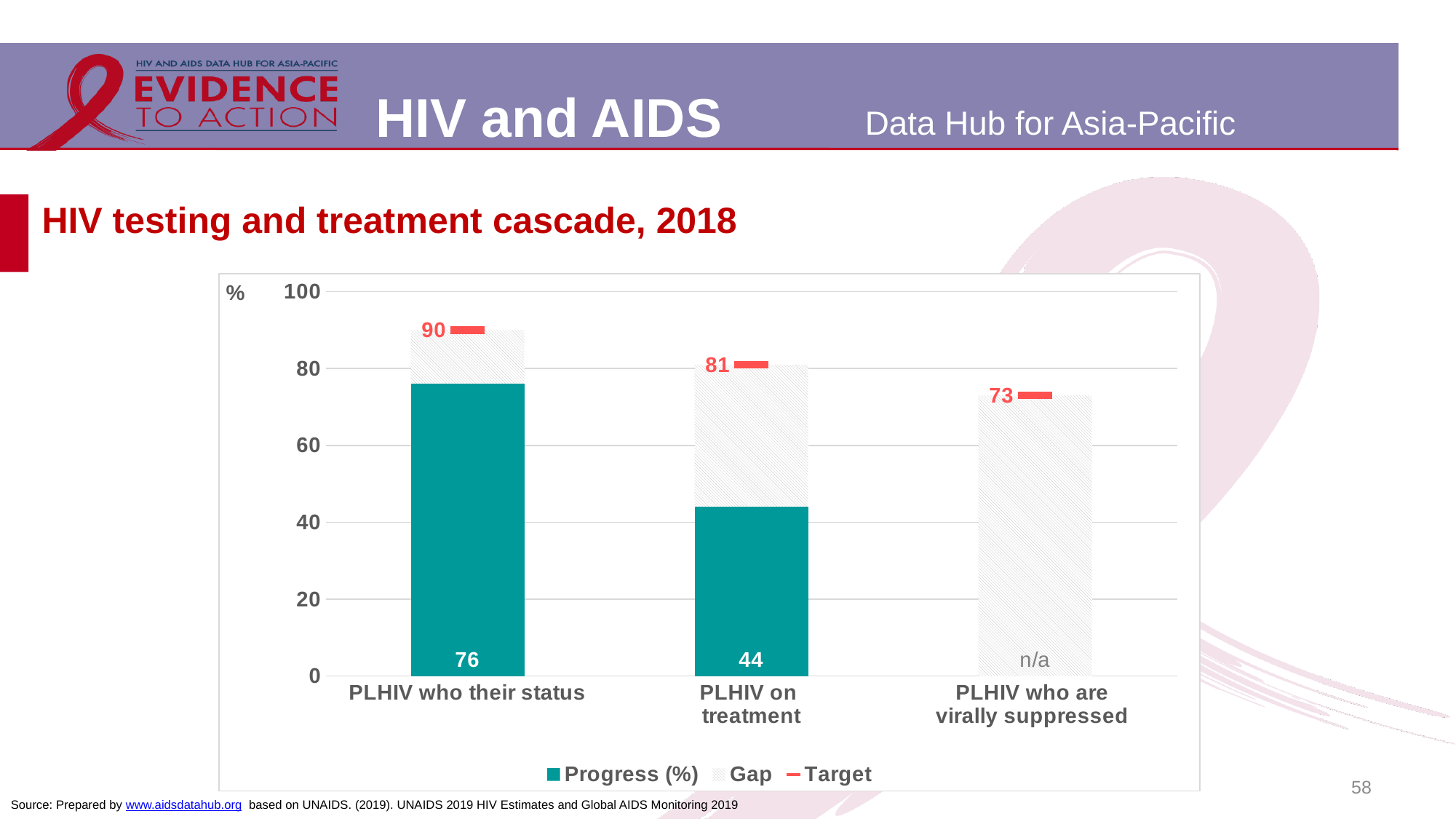
Which category has the lowest Target value? PLHIV who are virally suppressed What is the title of the chart? HIV testing and treatment cascade, 2018 What is the Target value for PLHIV who are virally suppressed? 73 What is the difference between the Target and the Progress (%) value for PLHIV on treatment? 37 Which is larger, the Progress (%) value for PLHIV who know their status or for PLHIV on treatment? PLHIV who their status What is the Progress (%) value for PLHIV on treatment? 44 How many series does the legend list? 3 Which category has the highest Target value? PLHIV who their status What is the Target value for PLHIV who know their status? 90 What is the Progress (%) value shown for PLHIV who are virally suppressed? n/a What is the Progress (%) value for PLHIV who know their status? 76 What is the Target value for PLHIV on treatment? 81